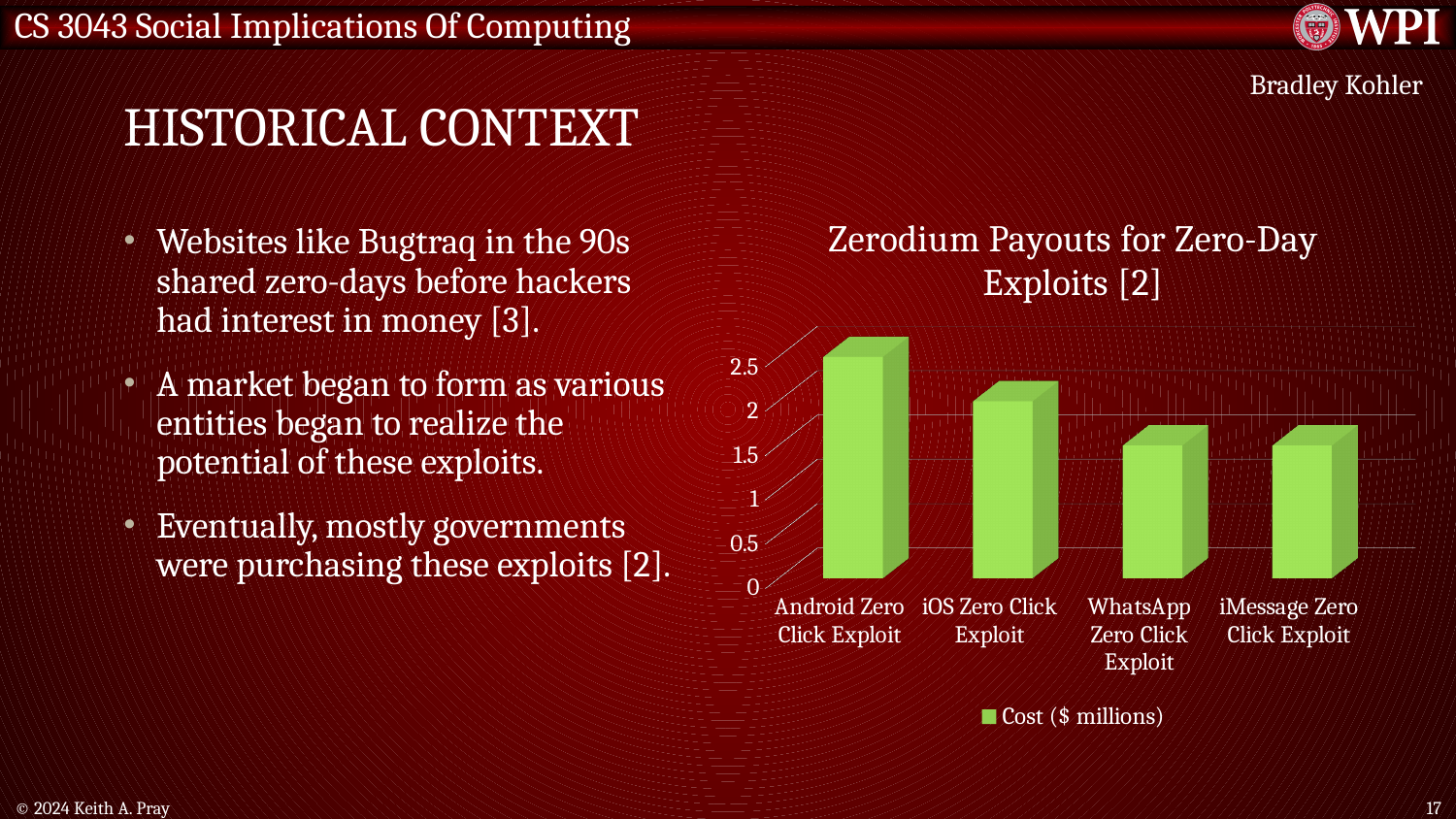
Is the value for the WhatsApp Zero Click Exploit greater or less than 2? less What is the cost in $ millions for the iOS Zero Click Exploit? 2 Is the value for the iMessage Zero Click Exploit greater or less than 1? greater What is the cost in $ millions for the Android Zero Click Exploit? 2.5 What is the title of the chart? Zerodium Payouts for Zero-Day Exploits [2] How many categories are shown on the x axis of the chart? 4 What kind of chart is shown on the slide? bar chart Do the bar values rise or fall moving from left to right along the x axis? fall What series name appears in the chart legend? Cost ($ millions) Which category has the highest payout in the chart? Android Zero Click Exploit How many series does the chart legend list? 1 Which is larger, the payout for the Android Zero Click Exploit or the iOS Zero Click Exploit? Android Zero Click Exploit